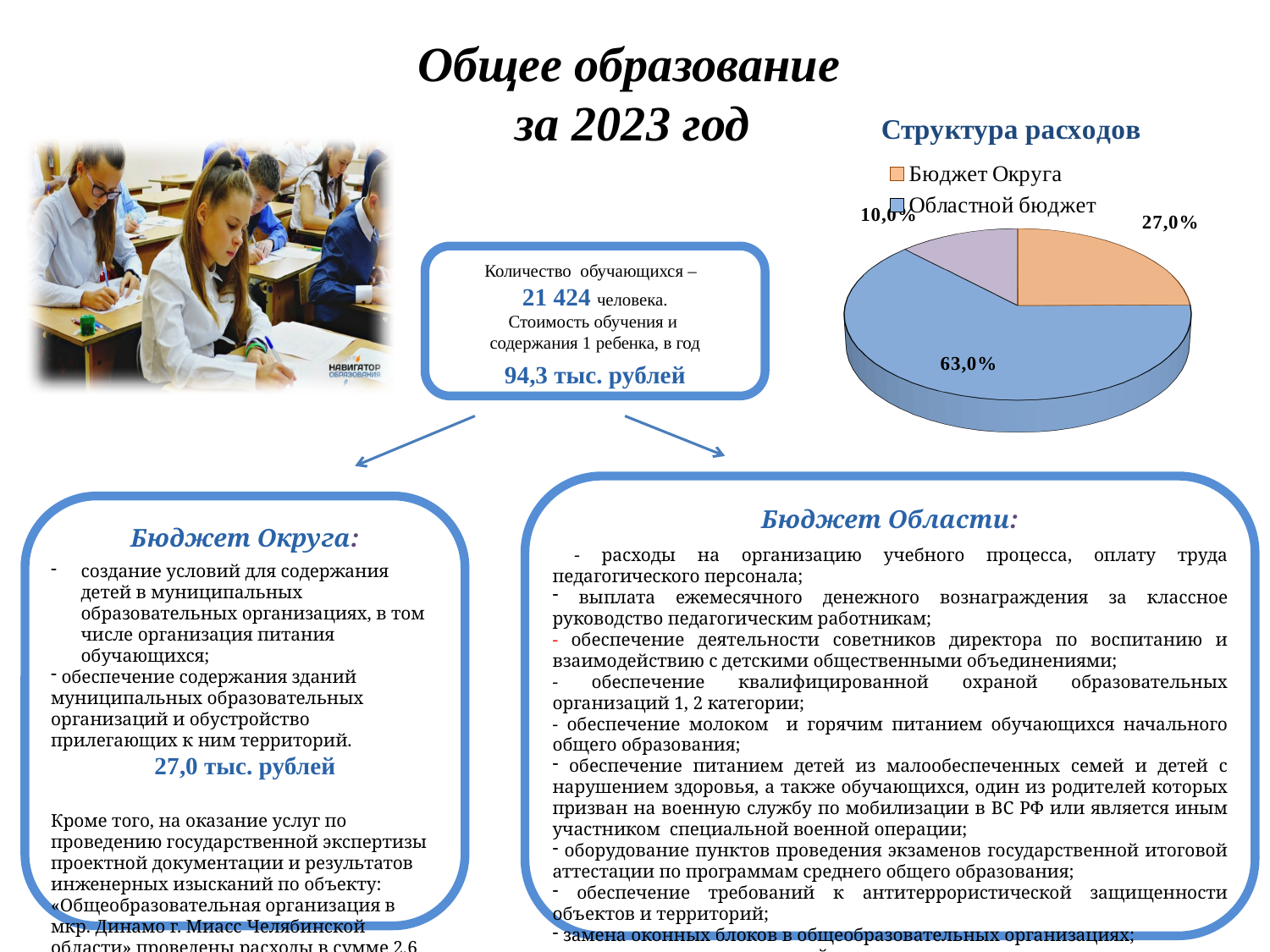
In the "Структура расходов" pie chart, is the share for Областной бюджет greater or less than 50%? greater In the "Структура расходов" pie chart, what share is labelled for Бюджет Округа? 27,0% What is the value of the smallest slice in the "Структура расходов" pie chart? 10,0% How many slices does the "Структура расходов" pie chart have? 3 What colour is the Областной бюджет slice in the "Структура расходов" pie chart? blue Which slice of the "Структура расходов" pie chart is the largest? Областной бюджет In the "Структура расходов" pie chart, what is the difference between the Областной бюджет share and the Бюджет Округа share? 36,0% In the "Структура расходов" pie chart, which is larger: Бюджет Округа or Областной бюджет? Областной бюджет What kind of chart is shown under the title "Структура расходов"? pie chart In the "Структура расходов" pie chart, what share is labelled for Областной бюджет? 63,0% What is the title of the chart on the slide? Структура расходов How many entries does the legend of the "Структура расходов" chart list? 2